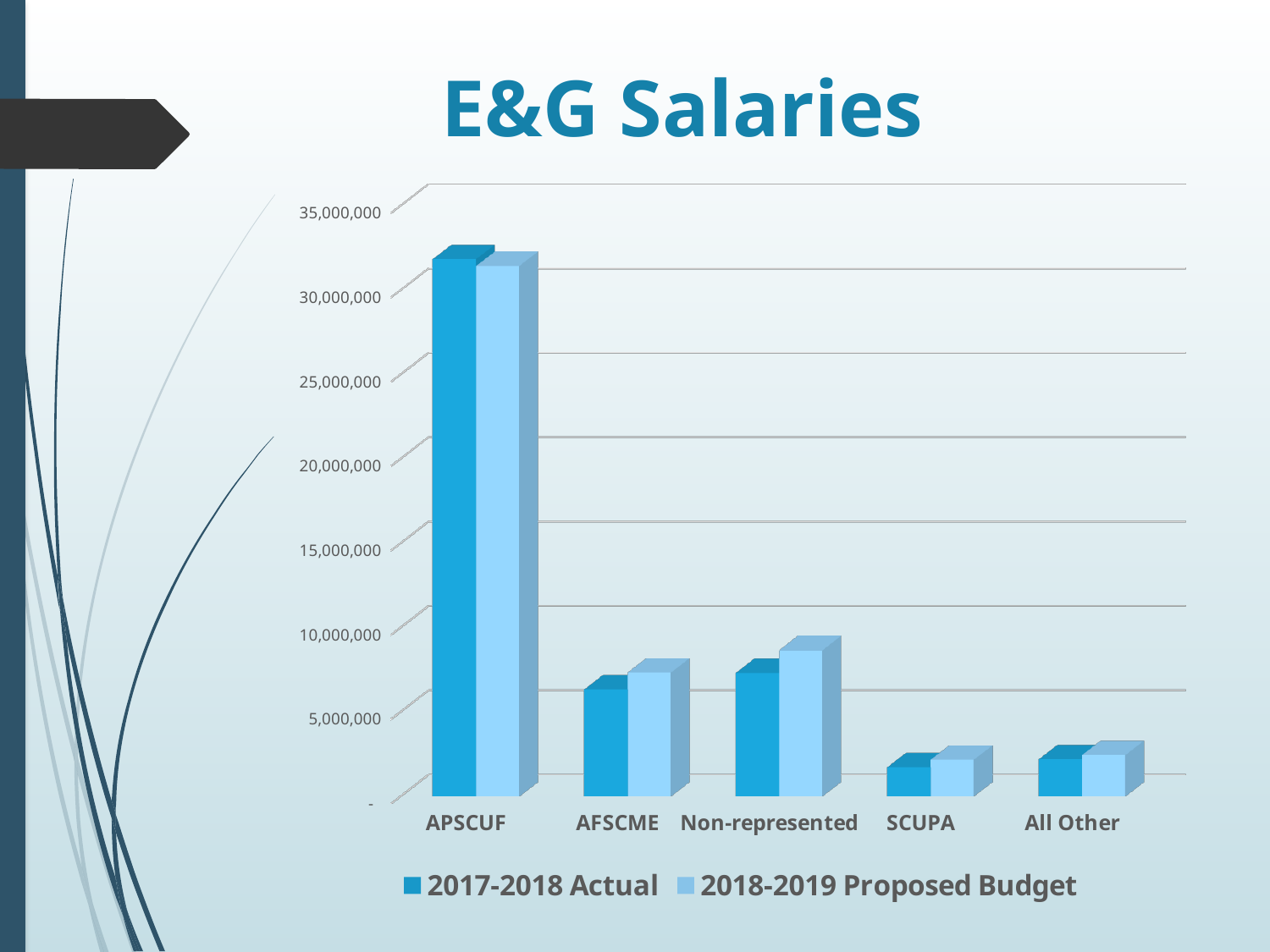
How many categories are shown on the x axis? 5 Which two series are listed in the legend? 2017-2018 Actual and 2018-2019 Proposed Budget What kind of chart is shown on the slide? Bar chart Which category has the lowest 2018-2019 Proposed Budget salaries? SCUPA Is the 2017-2018 Actual value for AFSCME greater or less than 5,000,000? greater What is the title of the chart? E&G Salaries How many series does the legend list? 2 Which category has the highest 2017-2018 Actual salaries? APSCUF Is the 2017-2018 Actual value for APSCUF greater or less than 30,000,000? greater Which category has a larger 2018-2019 Proposed Budget: AFSCME or SCUPA? AFSCME Is the 2018-2019 Proposed Budget value for Non-represented greater or less than 10,000,000? less For Non-represented, which is larger: the 2017-2018 Actual or the 2018-2019 Proposed Budget? 2018-2019 Proposed Budget